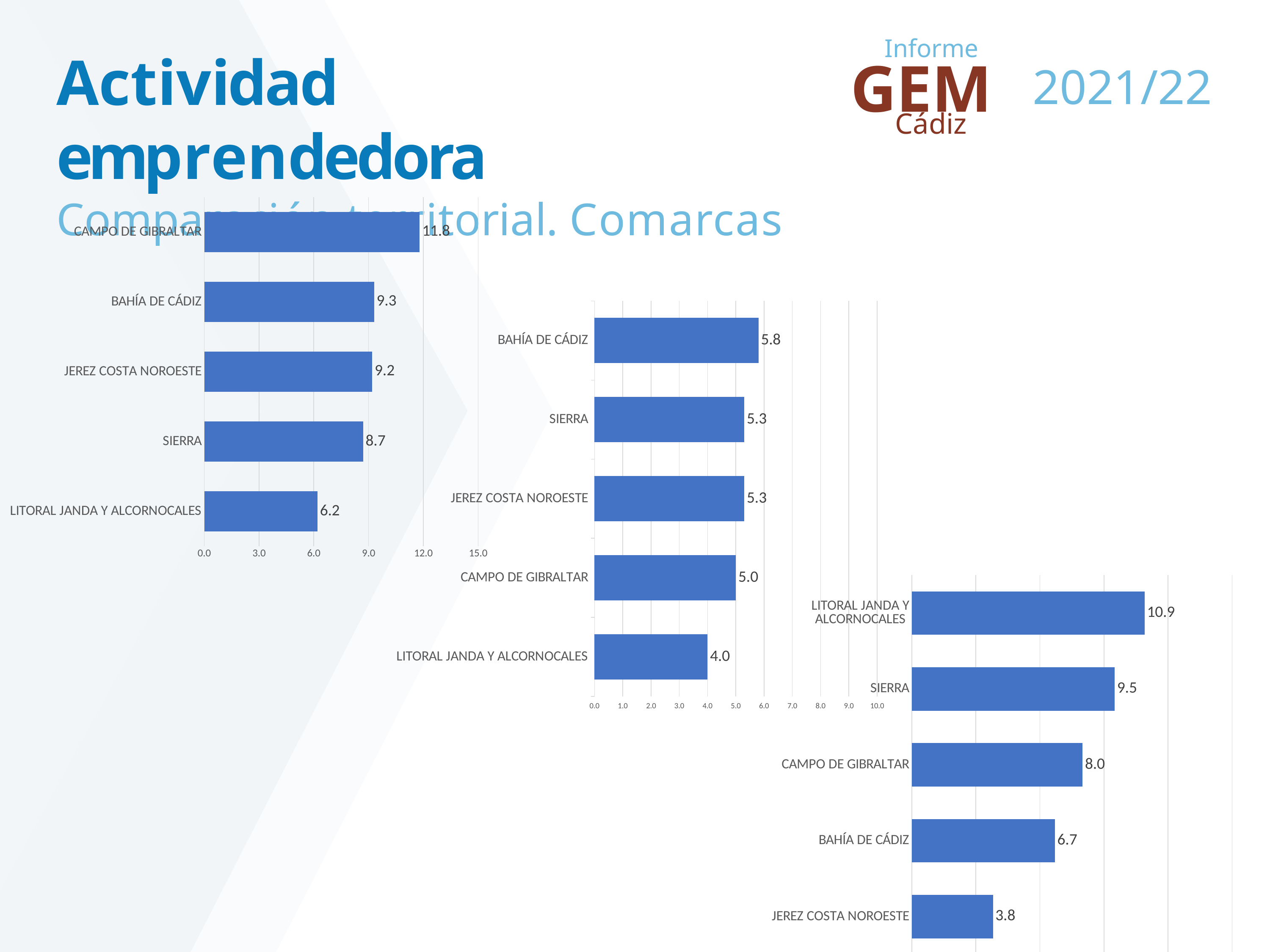
What kind of chart is the left chart? Bar chart On the middle chart, which category has the highest value? Bahía de Cádiz On the middle chart, what is the value for Litoral Janda y Alcornocales? 4.0 On the middle chart, how many categories are plotted? 5 On the left chart, what is the value for Campo de Gibraltar? 11.8 On the right chart, what is the difference between Litoral Janda y Alcornocales and Jerez Costa Noroeste? 7.1 On the right chart, which is larger, Campo de Gibraltar or Bahía de Cádiz? Campo de Gibraltar On the left chart, which category has the lowest value? Litoral Janda y Alcornocales On the left chart, what is the difference between Campo de Gibraltar and Litoral Janda y Alcornocales? 5.6 On the middle chart, what is the value for Bahía de Cádiz? 5.8 On the right chart, what is the value for Sierra? 9.5 On the right chart, which category has the lowest value? Jerez Costa Noroeste